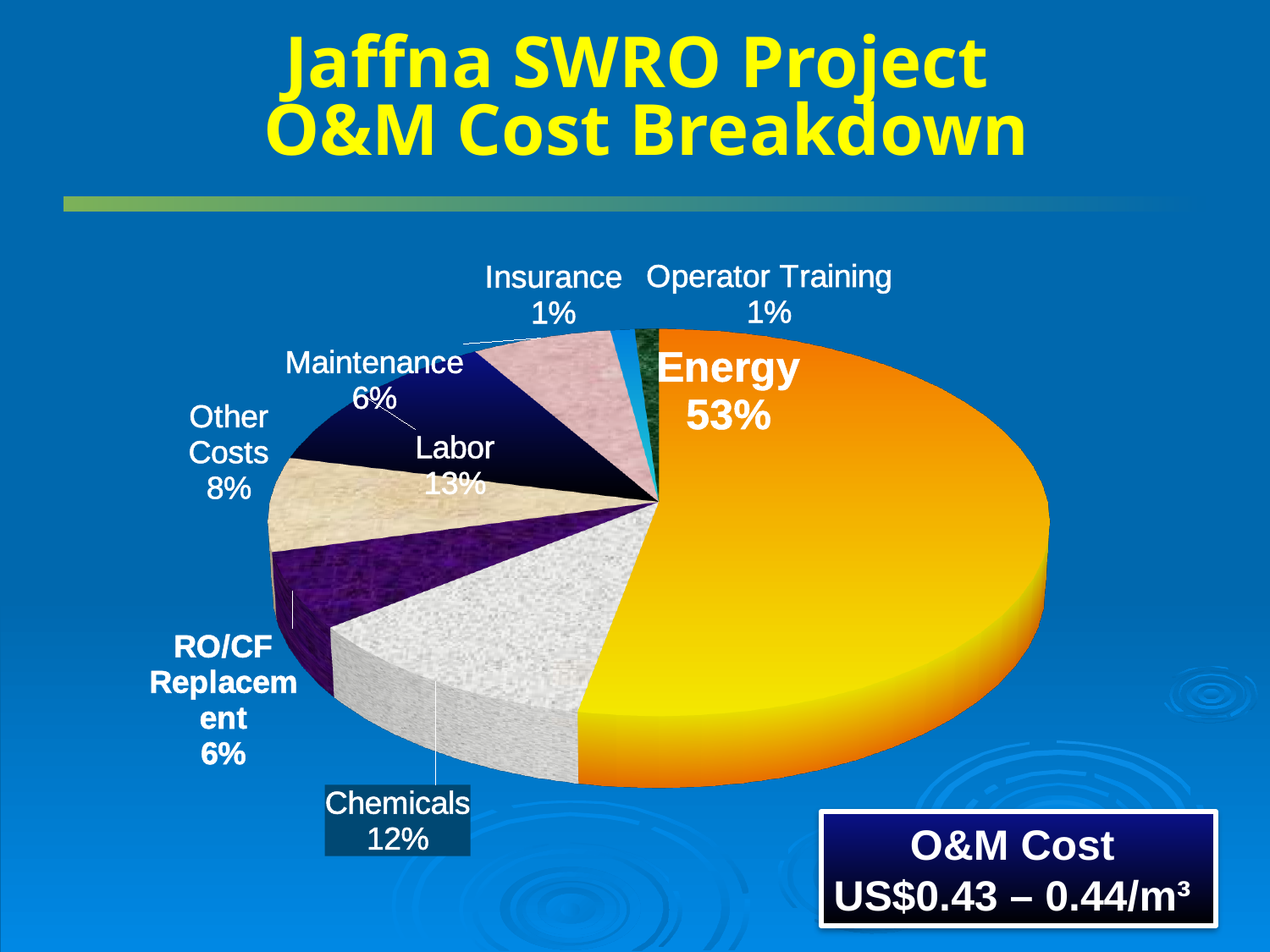
What is the difference in percentage points between Labor and Chemicals? 1 What percentage is shown for RO/CF Replacement? 6% Which is larger, the share for Other Costs or the share for Maintenance? Other Costs What percentage is shown for Chemicals? 12% What kind of chart is shown on the slide? Pie chart How many slices does the pie chart have? 8 What percentage is shown for Labor? 13% What percentage is shown for Other Costs? 8% What share of O&M cost does Energy account for? 53% What is the title of the slide containing the chart? Jaffna SWRO Project O&M Cost Breakdown What is the difference in percentage points between Energy and Labor? 40 Which category has the largest share of the pie? Energy